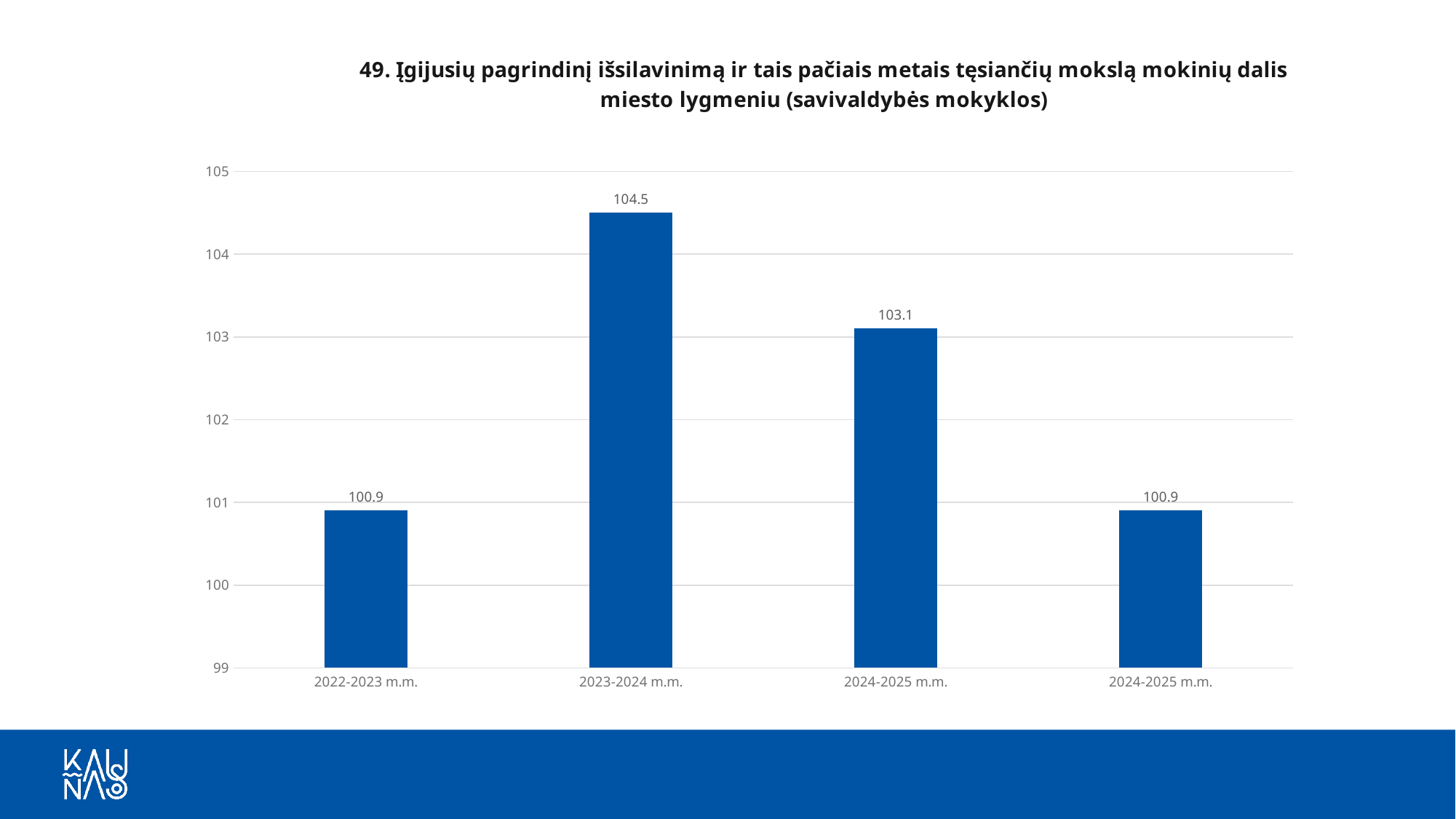
What is the value of the third bar from the left (the first bar labelled 2024-2025 m.m.)? 103.1 What is the difference between the value for 2023-2024 m.m. and the value for 2022-2023 m.m.? 3.6 What is the value of the rightmost bar (the second bar labelled 2024-2025 m.m.)? 100.9 Is the value for 2023-2024 m.m. greater or less than 102? greater How many bars are shown on the chart? 4 What is the difference between the value for 2023-2024 m.m. and the value of the third bar from the left (103.1)? 1.4 Which is larger: the value for 2023-2024 m.m. or the value of the third bar from the left? 2023-2024 m.m. What is the value for 2022-2023 m.m.? 100.9 What is the lowest value shown on the chart? 100.9 What is the value for 2023-2024 m.m.? 104.5 Which category has the highest value? 2023-2024 m.m. What kind of chart is shown on the slide? bar chart